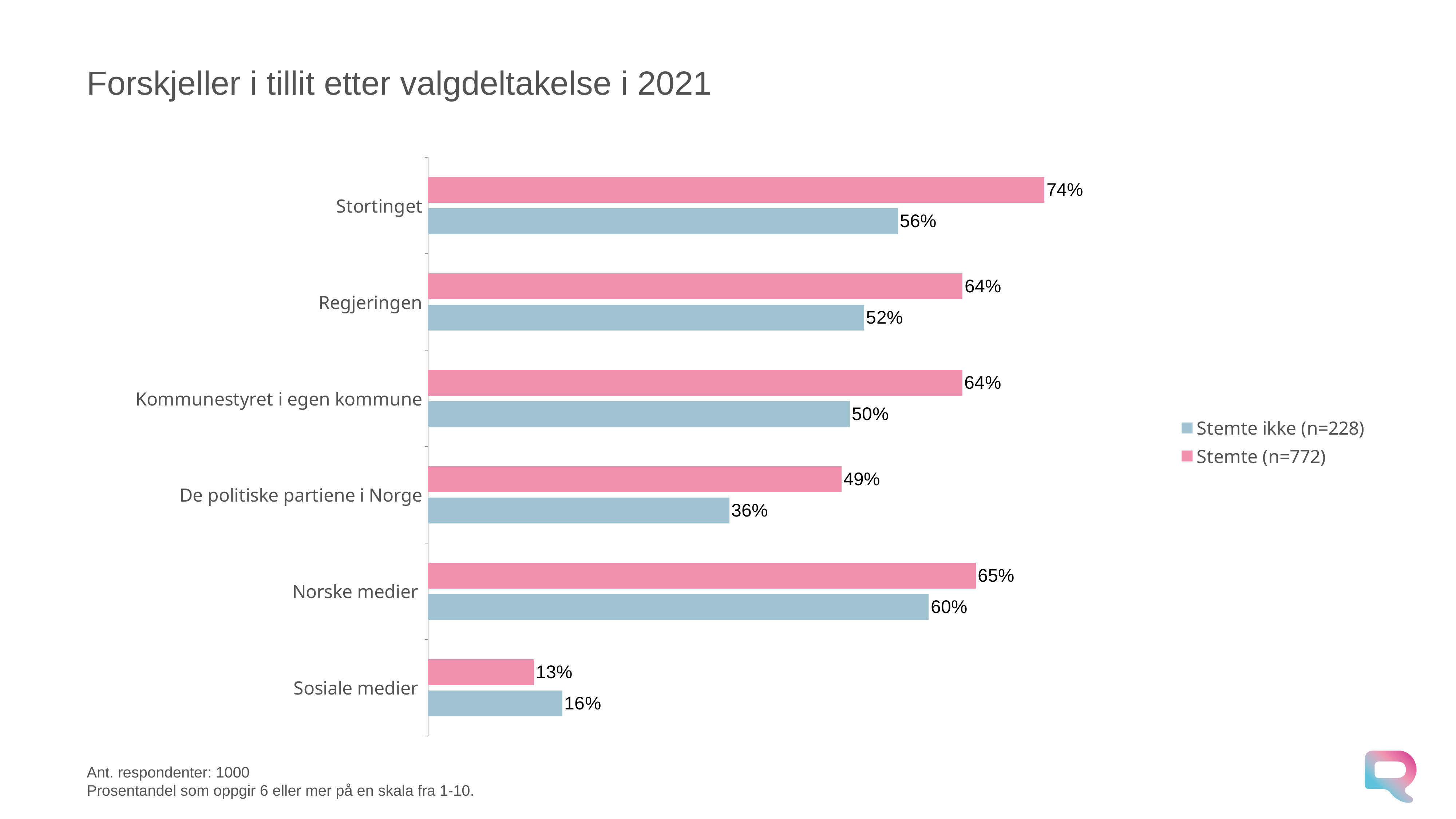
How many categories are shown on the chart? 6 What is the difference between the Stemte (n=772) and Stemte ikke (n=228) values for Norske medier? 5% What is the difference between the Stemte (n=772) and Stemte ikke (n=228) values for Stortinget? 18% What is the value for Sosiale medier in the Stemte (n=772) series? 13% For Regjeringen, which series has the larger value: Stemte ikke (n=228) or Stemte (n=772)? Stemte (n=772) What kind of chart is shown on the slide? Bar chart Which category has the lowest value in the Stemte ikke (n=228) series? Sosiale medier How many series does the legend list? 2 What is the value for De politiske partiene i Norge in the Stemte ikke (n=228) series? 36% What is the value for Stortinget in the Stemte (n=772) series? 74% Which category has the highest value in the Stemte (n=772) series? Stortinget For Sosiale medier, which series has the larger value: Stemte ikke (n=228) or Stemte (n=772)? Stemte ikke (n=228)